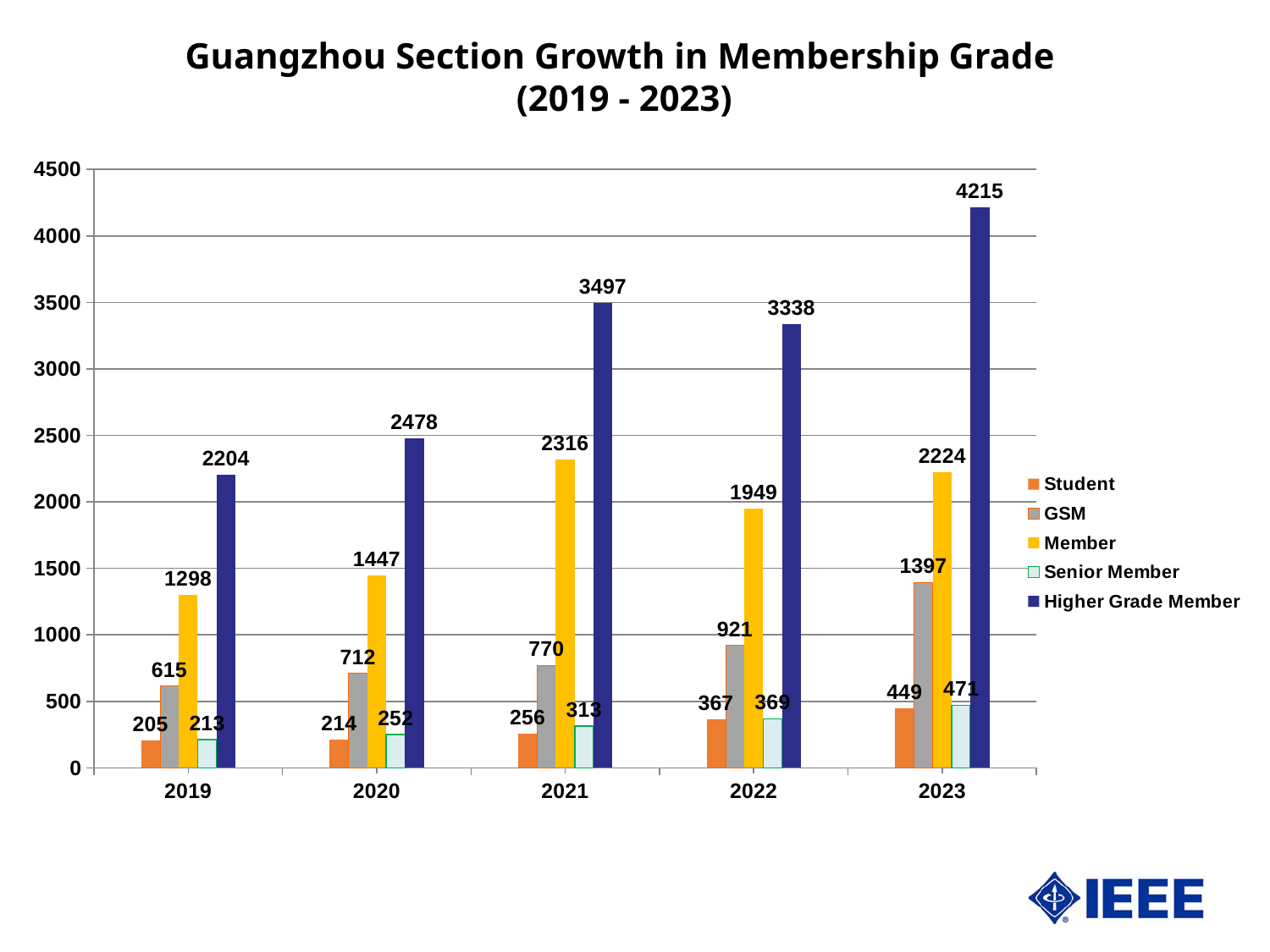
How many series does the legend list? 5 Does the Student value rise or fall from 2019 to 2023? rise In which year is the Student value lowest? 2019 What is the value for GSM in 2020? 712 What is the value for Higher Grade Member in 2023? 4215 What kind of chart is shown on the slide? bar chart In which year is the Higher Grade Member value highest? 2023 What is the difference between the Higher Grade Member values in 2023 and 2022? 877 Which is larger, the Member value in 2020 or the Member value in 2022? 2022 How many years are shown on the x axis? 5 What is the value for Member in 2021? 2316 What is the value for Senior Member in 2022? 369